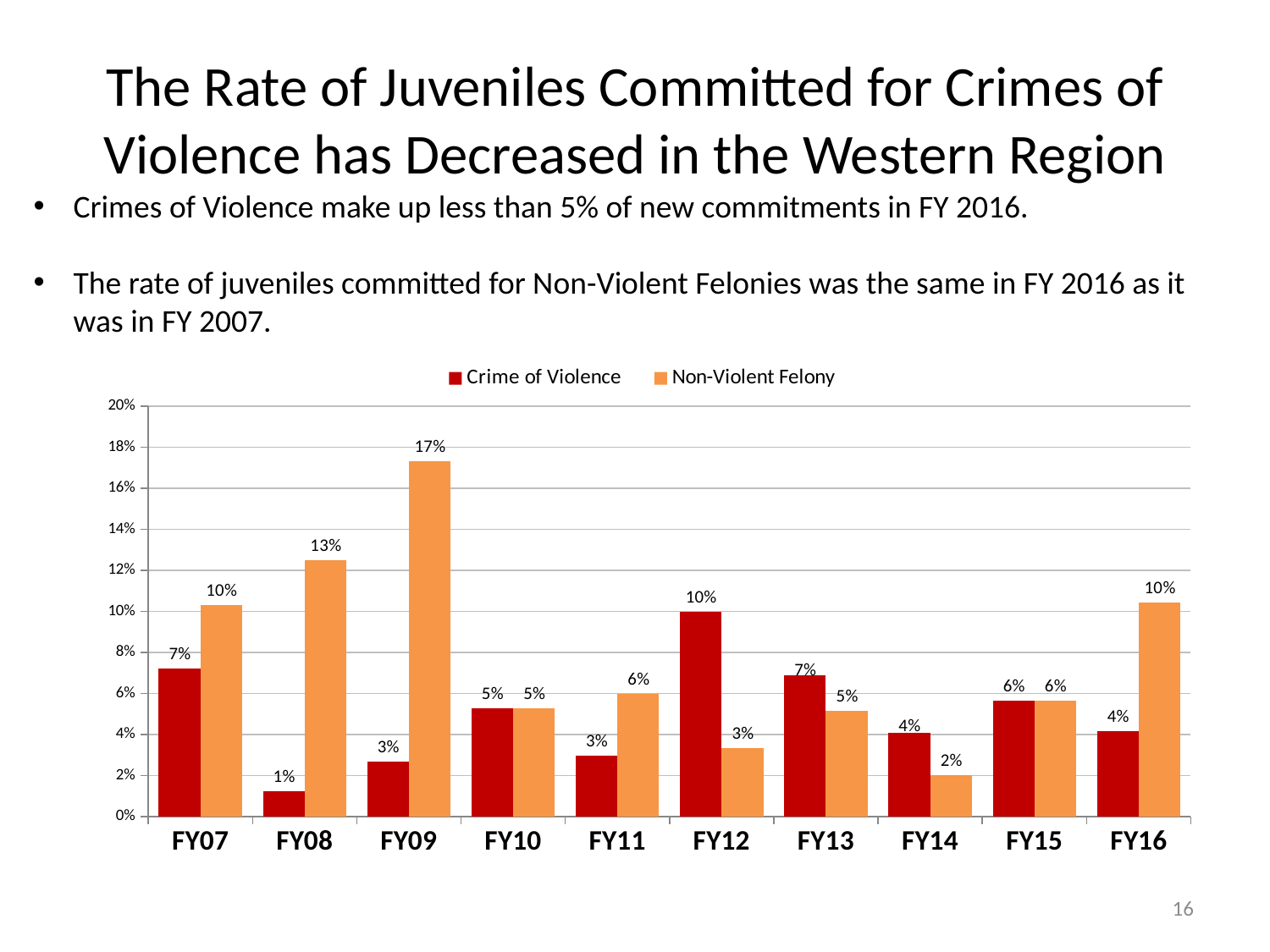
In FY12, which is larger: Crime of Violence or Non-Violent Felony? Crime of Violence What is the Crime of Violence value for FY12? 10% How many series does the legend list? 2 What is the difference between the Non-Violent Felony and Crime of Violence values in FY09? 14 percentage points What is the Crime of Violence value for FY16? 4% What kind of chart is shown on the slide? bar chart In which fiscal year is the Non-Violent Felony value highest? FY09 In which fiscal year is the Non-Violent Felony value lowest? FY14 How many fiscal years are shown on the x axis? 10 Is the Non-Violent Felony value for FY09 greater or less than 16%? greater In which fiscal year is the Crime of Violence value lowest? FY08 What is the Non-Violent Felony value for FY09? 17%